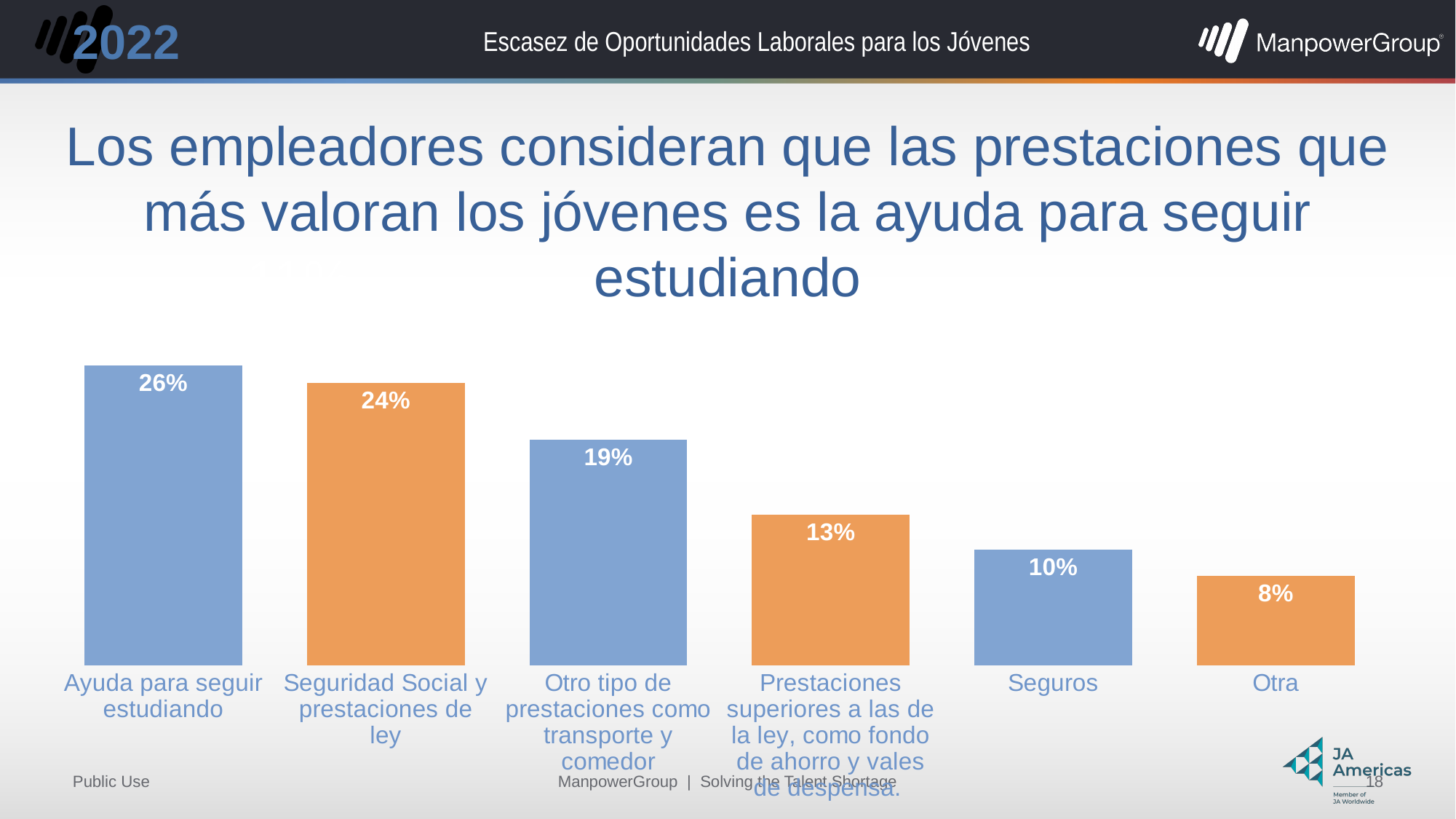
What is the value for "Otro tipo de prestaciones como transporte y comedor"? 19% What is the difference between the values for "Otro tipo de prestaciones como transporte y comedor" and "Seguros"? 9% What is the value for "Otra"? 8% Which category has the lowest value? Otra What is the value for "Ayuda para seguir estudiando"? 26% What is the difference between the values for "Ayuda para seguir estudiando" and "Seguridad Social y prestaciones de ley"? 2% Do the values rise or fall from left to right across the categories? Fall What kind of chart is shown on the slide? Bar chart Which is larger: the value for "Prestaciones superiores a las de la ley, como fondo de ahorro y vales de despensa" or the value for "Seguros"? Prestaciones superiores a las de la ley, como fondo de ahorro y vales de despensa Which category has the highest value? Ayuda para seguir estudiando What is the value for "Seguros"? 10% How many categories are shown in the chart? 6